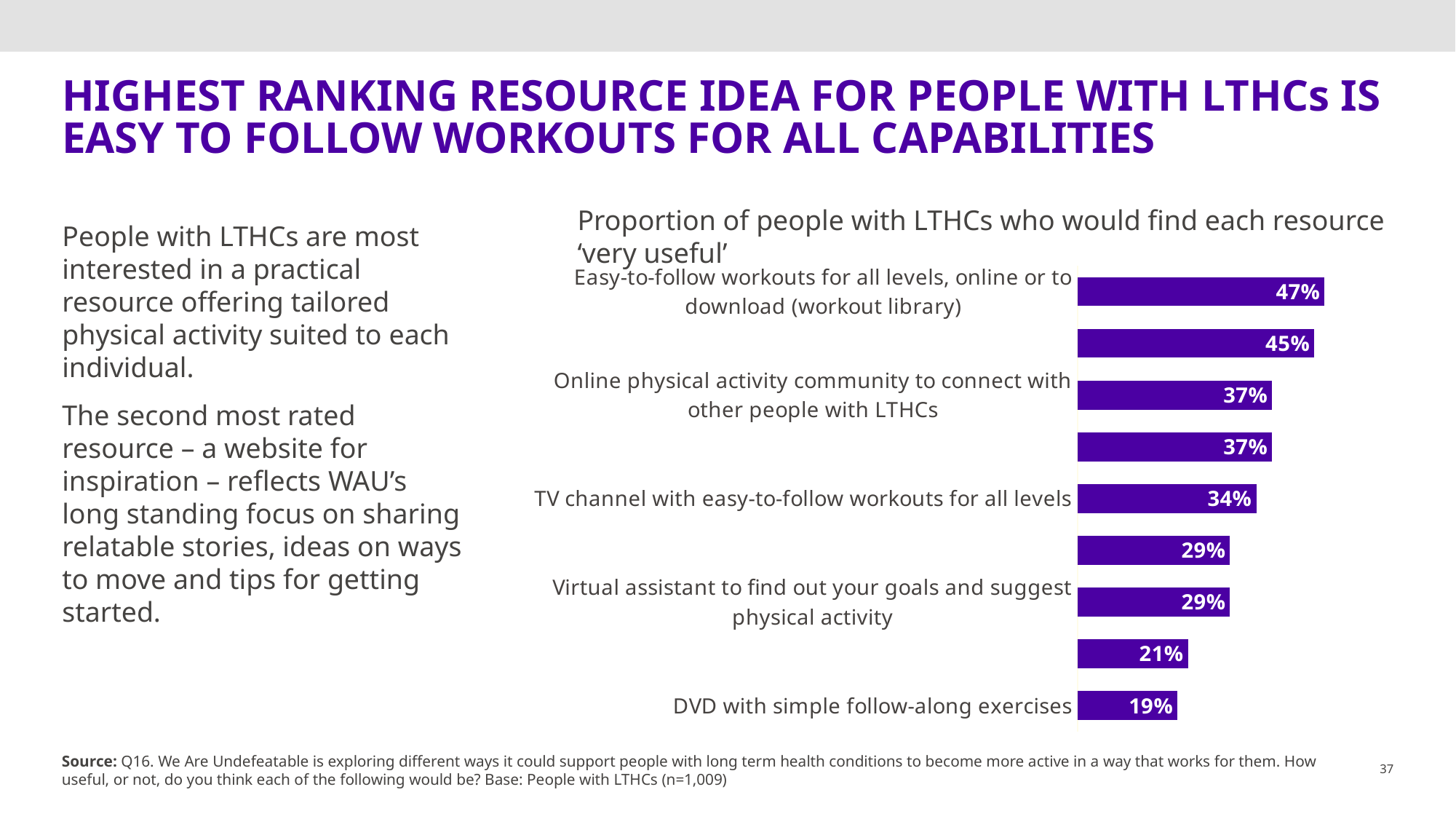
What proportion of people with LTHCs would find an online physical activity community to connect with other people with LTHCs 'very useful'? 37% Which resource has the highest proportion of people with LTHCs rating it 'very useful'? Easy-to-follow workouts for all levels, online or to download (workout library) How many bars are plotted in the chart? 9 What type of chart is shown on the slide? Bar chart What is the title of the chart? Proportion of people with LTHCs who would find each resource 'very useful' Which is rated 'very useful' by a larger proportion: the TV channel with easy-to-follow workouts or the virtual assistant? TV channel with easy-to-follow workouts for all levels What is the difference in percentage points between the easy-to-follow workouts (workout library) and the DVD with simple follow-along exercises? 28 percentage points What proportion of people with LTHCs would find easy-to-follow workouts for all levels, online or to download (workout library) 'very useful'? 47% What proportion of people with LTHCs would find a virtual assistant to find out your goals and suggest physical activity 'very useful'? 29% Which resource has the lowest proportion of people with LTHCs rating it 'very useful'? DVD with simple follow-along exercises What proportion of people with LTHCs would find a DVD with simple follow-along exercises 'very useful'? 19% What proportion of people with LTHCs would find a TV channel with easy-to-follow workouts for all levels 'very useful'? 34%